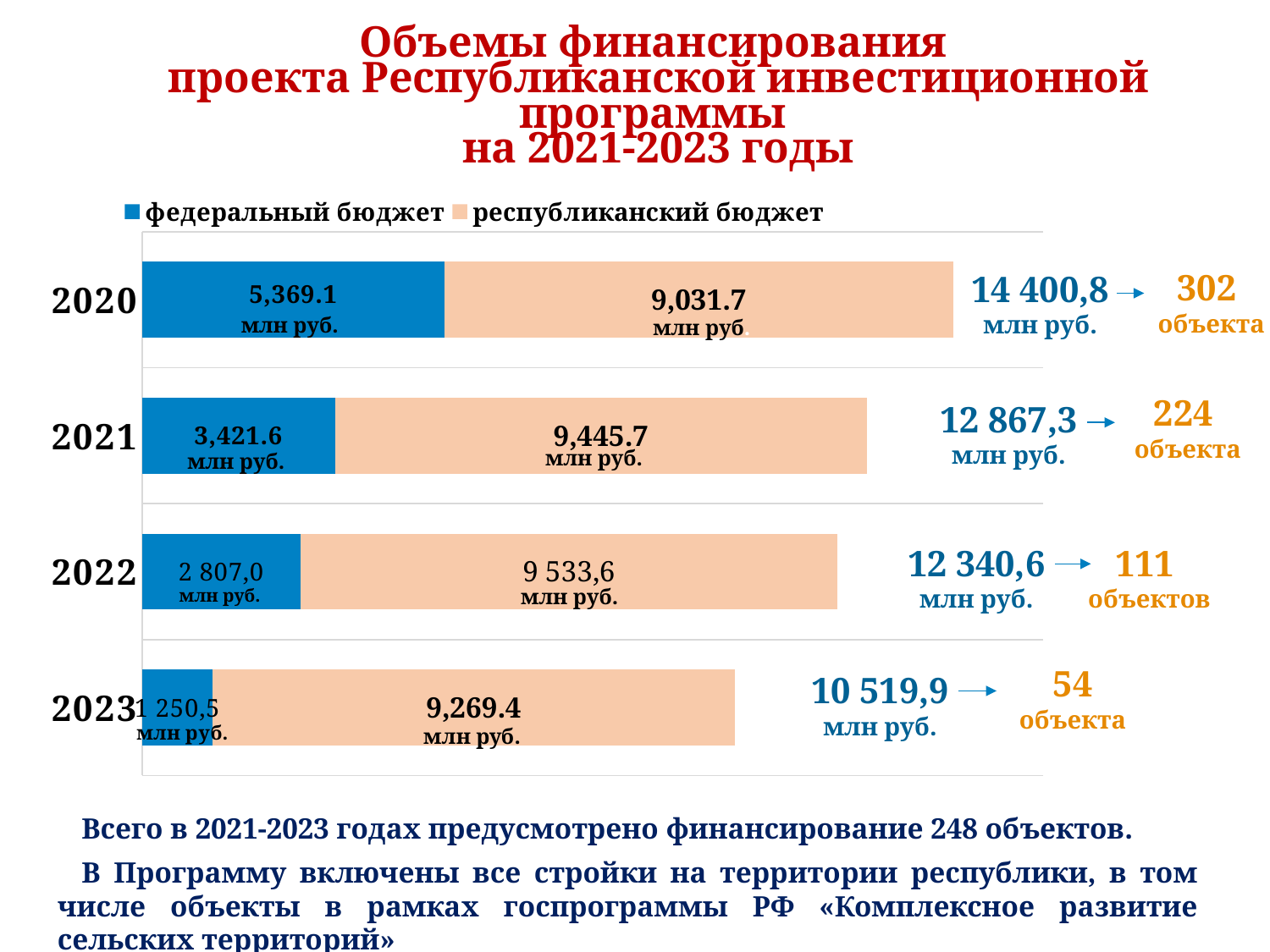
What is the federal budget value for 2022? 2 807,0 млн руб. Which year has the smallest federal budget value? 2023 What is the republican budget (республиканский бюджет) value for 2021? 9,445.7 млн руб. What is the total funding shown for 2020? 14 400,8 млн руб. How many series does the legend list? 2 What is the difference between the federal budget for 2020 and for 2021? 1,947.5 млн руб. Which year has the largest federal budget value? 2020 What is the federal budget (федеральный бюджет) value for 2020? 5,369.1 млн руб. Which is larger, the federal budget for 2021 or for 2022? 2021 Does the federal budget value rise or fall from 2020 to 2023? fall What is the republican budget value for 2023? 9,269.4 млн руб. What kind of chart is shown on the slide? stacked bar chart